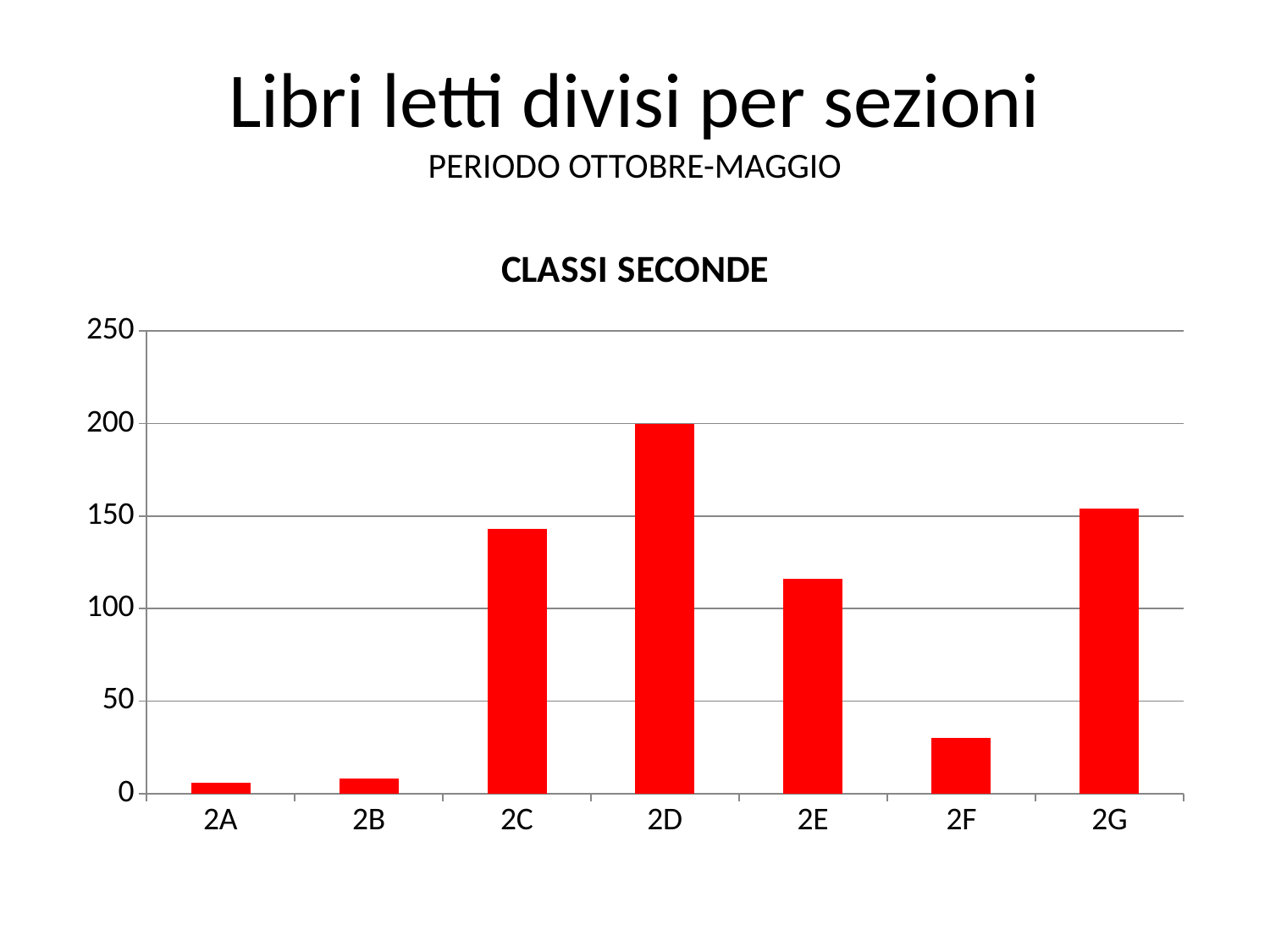
Is the value for 2E greater or less than 150? less Which is larger, the value for 2C or the value for 2E? 2C Is the value for 2F greater or less than 50? less Is the value for 2C greater or less than 100? greater How many classes (categories) are shown on the x axis? 7 What is the value for 2D? 200 Which is larger, the value for 2F or the value for 2B? 2F Which class has the highest value? 2D What type of chart is shown on the slide? bar chart What is the title of the chart? CLASSI SECONDE Which class has the lowest value? 2A